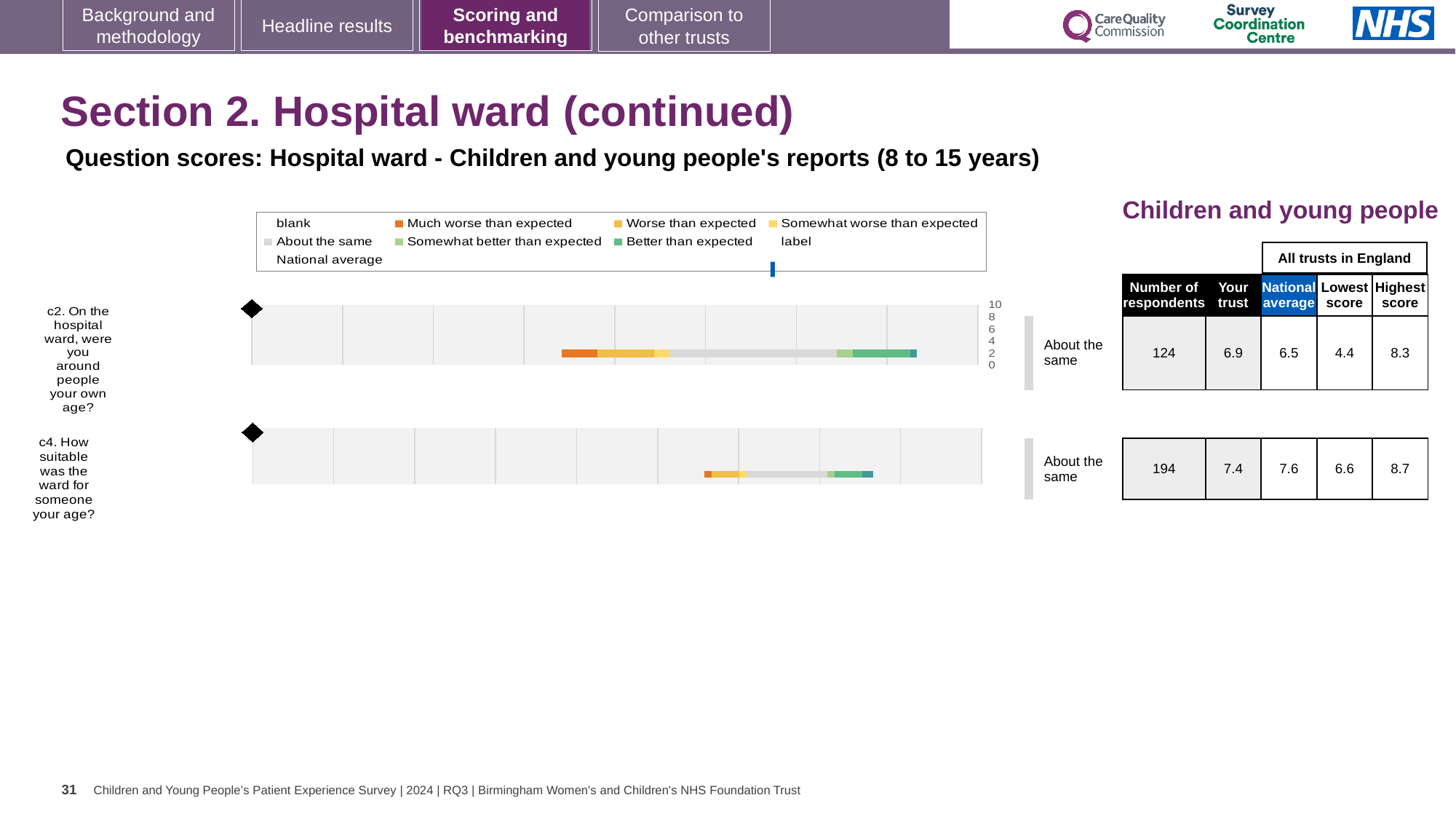
For question c4, what is the difference between the highest score and the lowest score among all trusts in England? 2.1 What is the number of respondents for question c2 (On the hospital ward, were you around people your own age?)? 124 What is the 'Your trust' score for question c4 (How suitable was the ward for someone your age?)? 7.4 For question c2, how much higher is the 'Your trust' score than the national average? 0.4 What benchmark category is shown next to the chart for question c2? About the same How many questions are plotted on the slide? 2 Which question has the larger number of respondents, c2 or c4? c4 What is the lowest score among all trusts in England for question c2? 4.4 What colour does the legend use for 'Much worse than expected'? orange What is the national average score for question c2? 6.5 What kind of chart is used to show the benchmark range for question c2? bar chart For question c4, is the 'Your trust' score higher or lower than the national average? lower